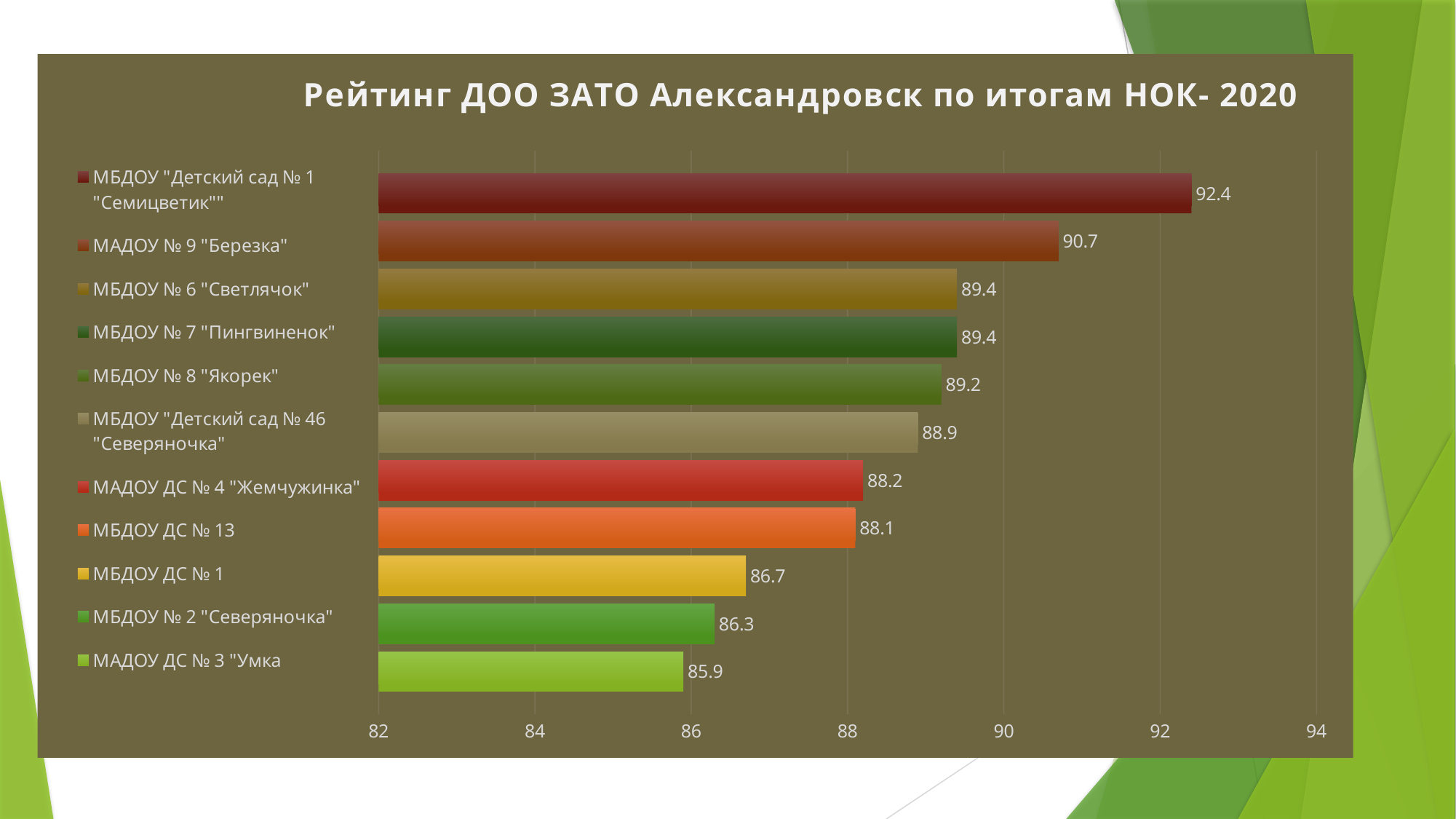
What is the value for МБДОУ "Детский сад № 1 "Семицветик""? 92.4 Is the value for МАДОУ ДС № 4 "Жемчужинка" greater or less than 90? less Which is larger, the value for МБДОУ ДС № 1 or the value for МБДОУ № 2 "Северяночка"? МБДОУ ДС № 1 What is the value for МАДОУ № 9 "Березка"? 90.7 Which organisation has the highest value? МБДОУ "Детский сад № 1 "Семицветик"" How many organisations are shown in the chart? 11 What is the difference between the values for МБДОУ "Детский сад № 1 "Семицветик"" and МАДОУ ДС № 3 "Умка? 6.5 What is the value for МБДОУ № 8 "Якорек"? 89.2 What kind of chart is shown on the slide? bar chart What is the value for МБДОУ ДС № 13? 88.1 Which organisation has the lowest value? МАДОУ ДС № 3 "Умка What is the title of the chart? Рейтинг ДОО ЗАТО Александровск по итогам НОК- 2020